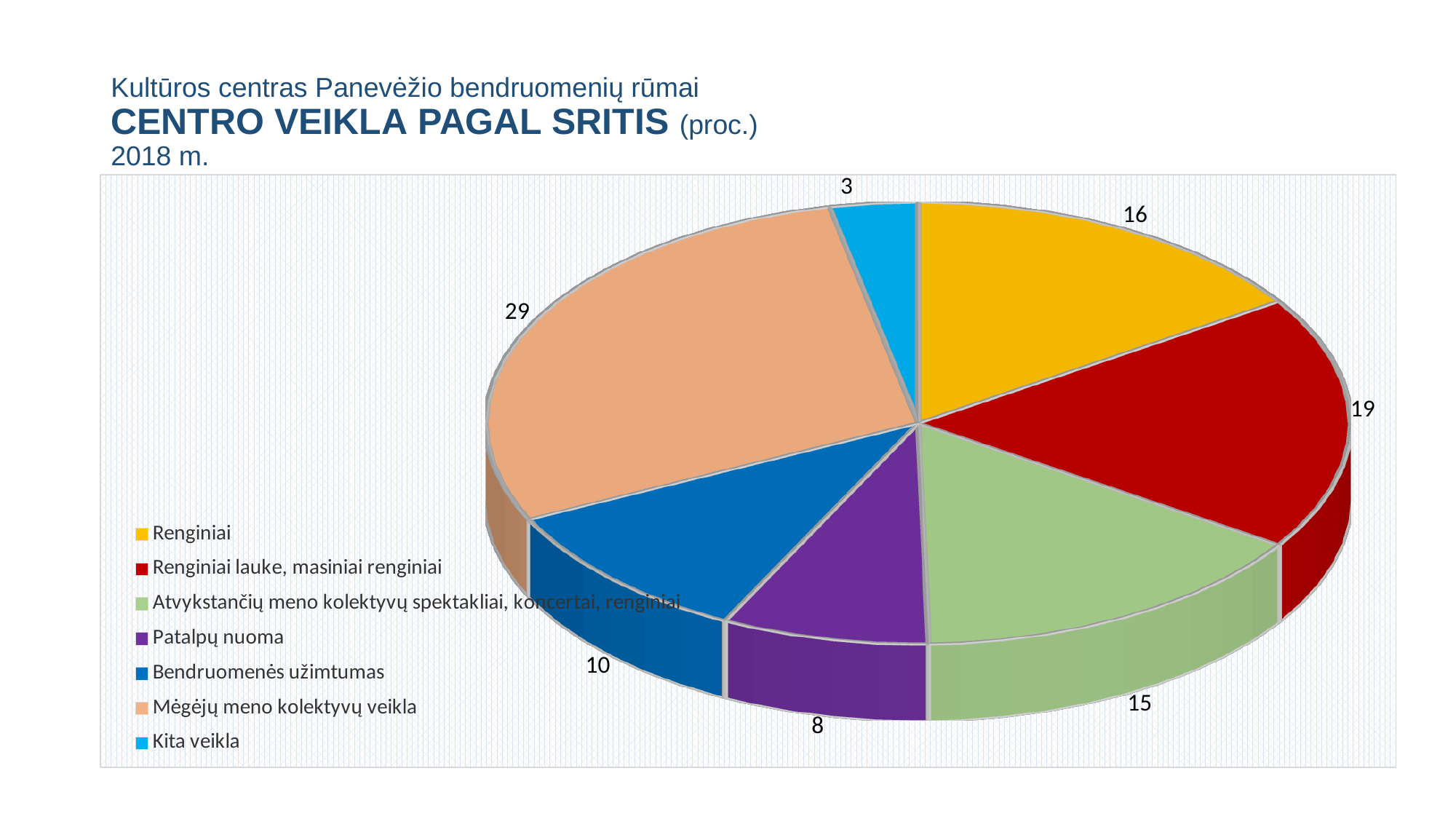
What is the value for Mėgėjų meno kolektyvų veikla? 29 How many categories does the pie chart have? 7 Which category has the largest slice? Mėgėjų meno kolektyvų veikla What is the value for Renginiai lauke, masiniai renginiai? 19 What is the value for Patalpų nuoma? 8 What is the value for Kita veikla? 3 Which is larger, Bendruomenės užimtumas or Patalpų nuoma? Bendruomenės užimtumas What share of the pie does Atvykstančių meno kolektyvų spektakliai, koncertai, renginiai represent? 15% Which category has the smallest slice? Kita veikla Which year does the chart title refer to? 2018 m. What is the difference between the values for Renginiai lauke, masiniai renginiai and Renginiai? 3 What kind of chart is shown on the slide? Pie chart